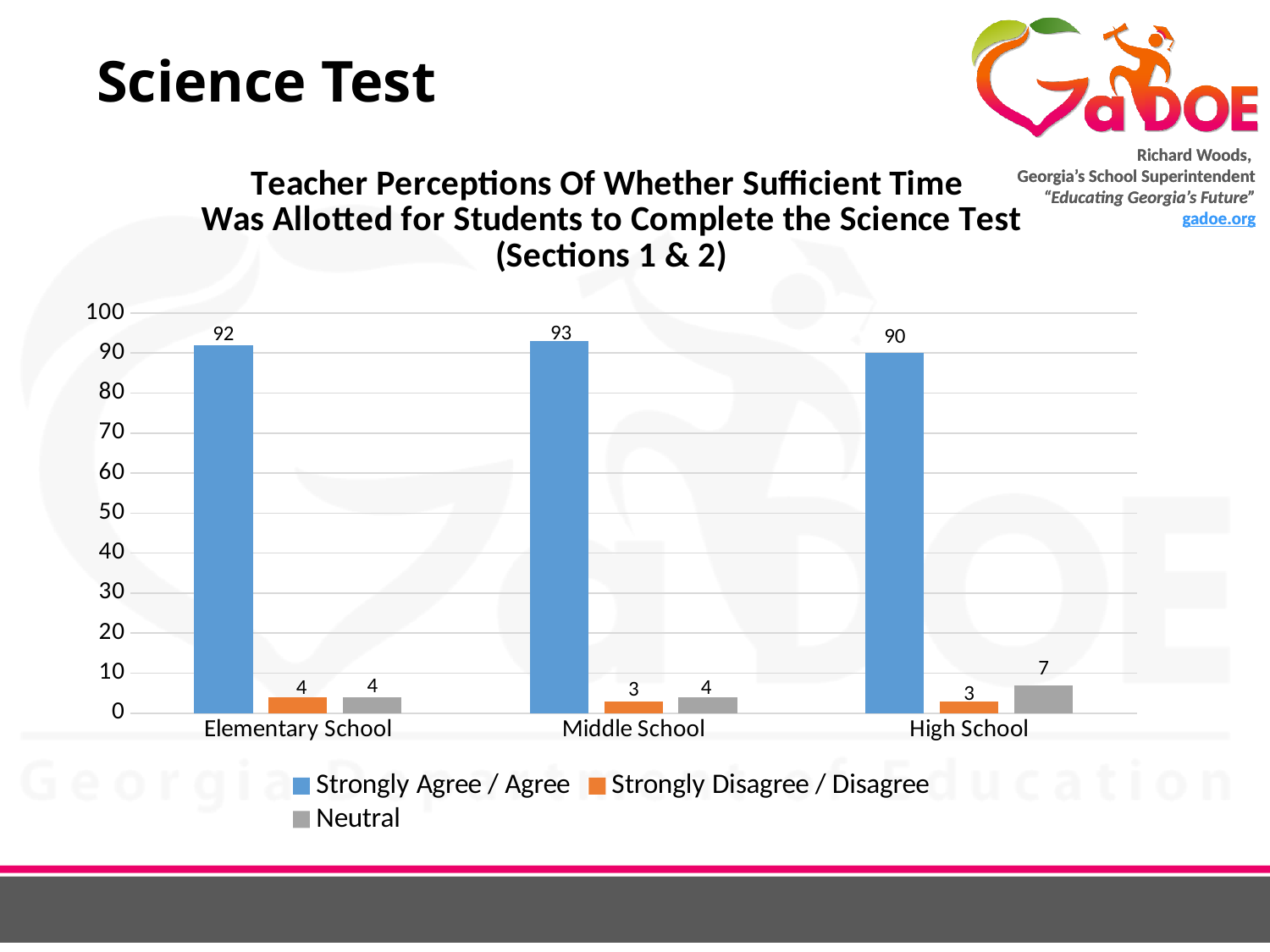
What is the Strongly Agree / Agree value for Middle School? 93 Which school level has the highest Strongly Agree / Agree value? Middle School How many series does the legend list? 3 Is the Strongly Agree / Agree value for Elementary School greater or less than 90? greater Which school level has the lowest Strongly Agree / Agree value? High School Is the Neutral value for High School larger than the Neutral value for Elementary School? Yes What is the Neutral value for High School? 7 What is the difference between the Strongly Agree / Agree values for Middle School and High School? 3 Which colour represents the Neutral series? Gray How many school levels are shown on the x axis? 3 What is the Strongly Disagree / Disagree value for Elementary School? 4 What kind of chart is shown on the slide? Bar chart